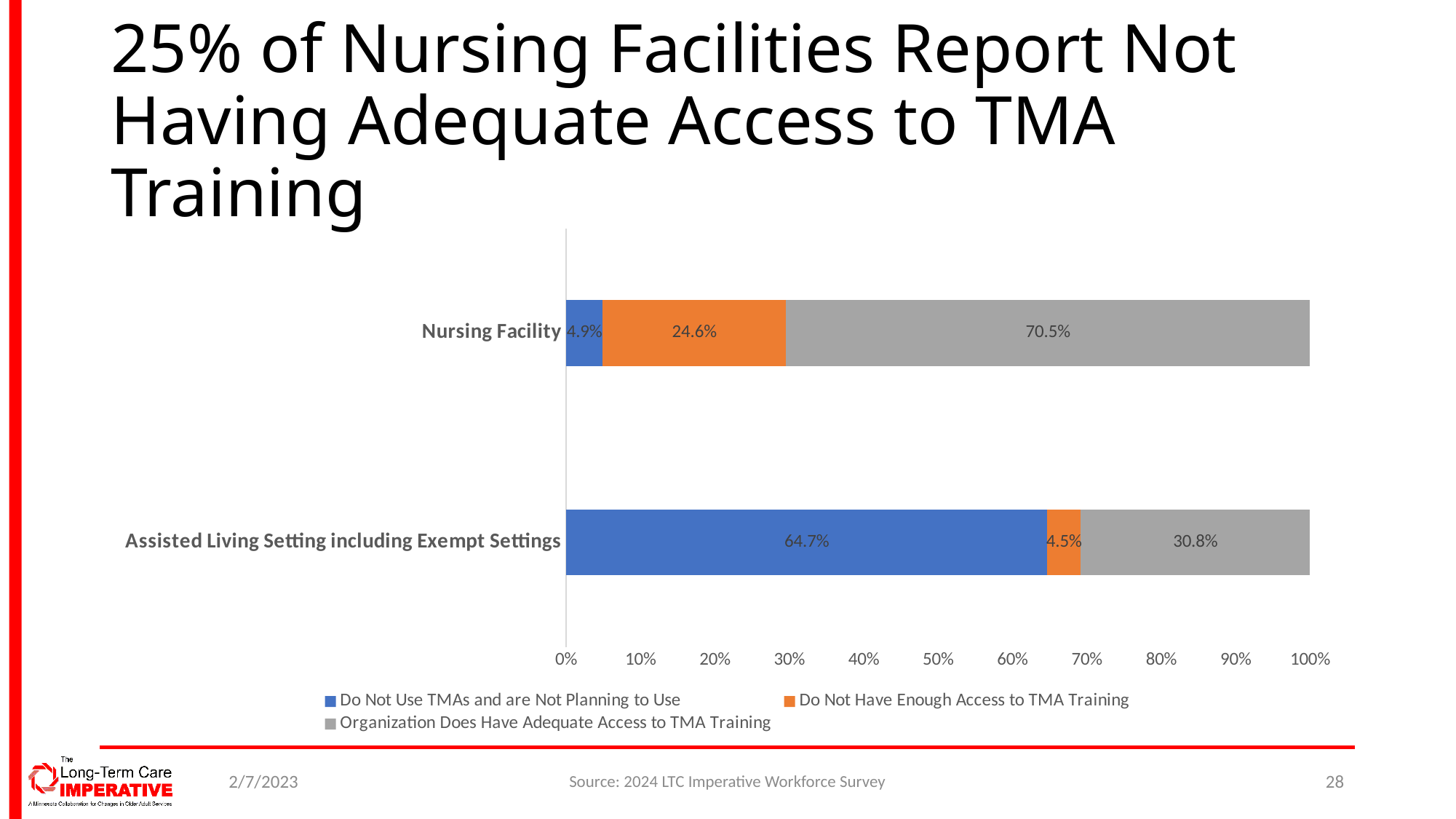
How many series does the legend list? 3 What is the difference between the Nursing Facility and Assisted Living Setting shares for 'Organization Does Have Adequate Access to TMA Training'? 39.7% Which colour represents 'Do Not Have Enough Access to TMA Training' in the chart? Orange What percentage of Nursing Facilities report that their organization does have adequate access to TMA training? 70.5% What is the difference between the 'Do Not Have Enough Access to TMA Training' shares for Nursing Facility and Assisted Living Setting including Exempt Settings? 20.1% How many categories are shown on the chart? 2 What kind of chart is shown on the slide? Stacked bar chart What percentage of Nursing Facilities report not having enough access to TMA training? 24.6% Is the 'Do Not Use TMAs and are Not Planning to Use' value for Nursing Facility greater or less than 10%? less What percentage of Assisted Living Settings including Exempt Settings do not use TMAs and are not planning to use them? 64.7% Which category has the higher share of organizations that do not use TMAs and are not planning to use them? Assisted Living Setting including Exempt Settings What percentage of Assisted Living Settings including Exempt Settings report having adequate access to TMA training? 30.8%